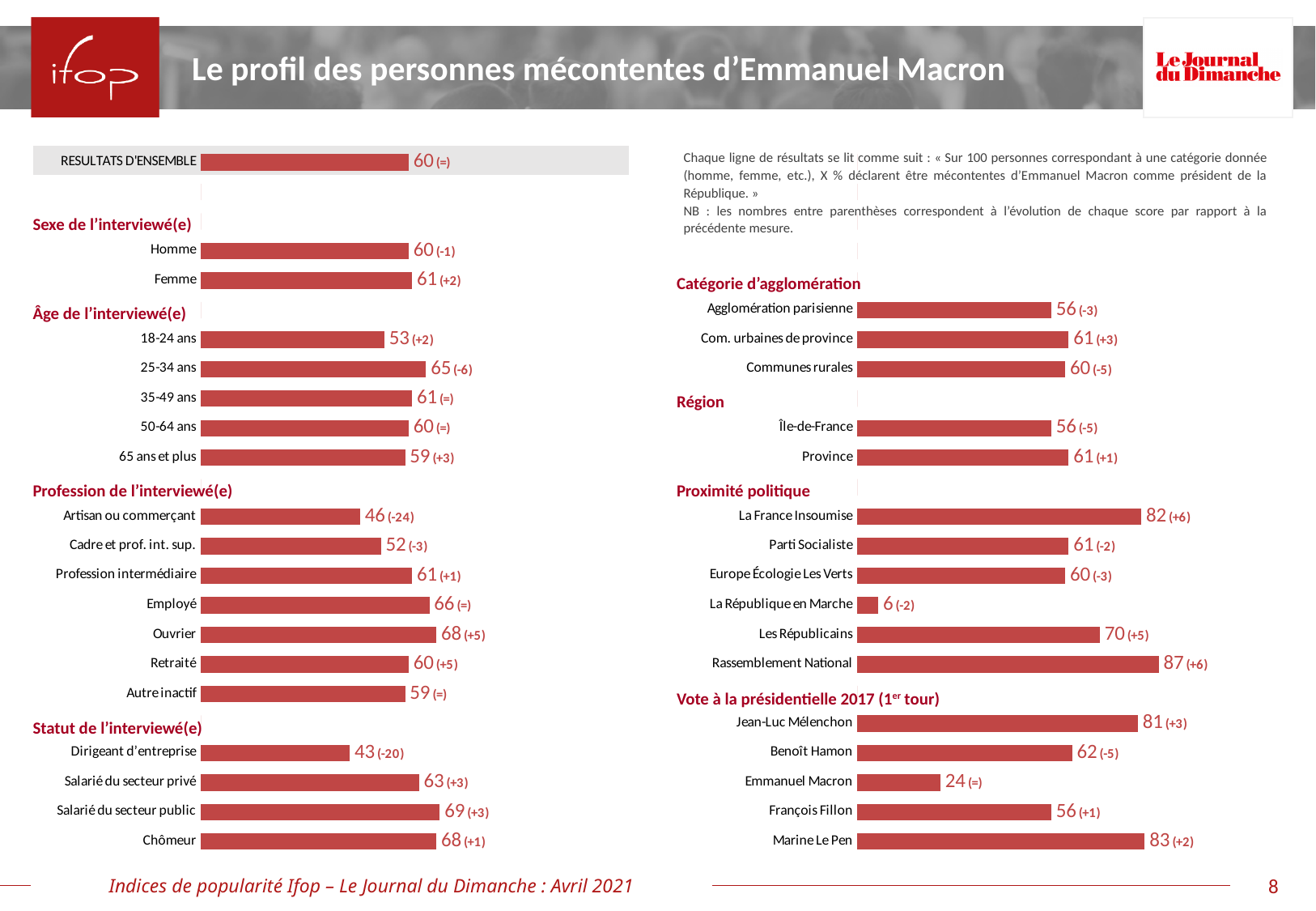
In the 'Profession de l'interviewé(e)' chart, which category has the highest value? Ouvrier In the 'Âge de l'interviewé(e)' chart, which category has the lowest value? 18-24 ans In the 'Catégorie d'agglomération' chart, what is the value for Agglomération parisienne? 56 In the 'Statut de l'interviewé(e)' chart, what is the difference between Salarié du secteur public and Dirigeant d'entreprise? 26 In the 'Proximité politique' chart, which category has the lowest value? La République en Marche In the 'Vote à la présidentielle 2017 (1er tour)' chart, what is the value for Emmanuel Macron? 24 In the 'Profession de l'interviewé(e)' chart, what change from the previous measure is shown in parentheses for Artisan ou commerçant? -24 What is the value shown for RESULTATS D'ENSEMBLE at the top of the slide? 60 How many categories are shown in the 'Âge de l'interviewé(e)' chart? 5 In the 'Proximité politique' chart, what is the value for Rassemblement National? 87 In the 'Vote à la présidentielle 2017 (1er tour)' chart, which is larger, the value for Marine Le Pen or for Jean-Luc Mélenchon? Marine Le Pen What kind of chart is used in the 'Région' section? Bar chart